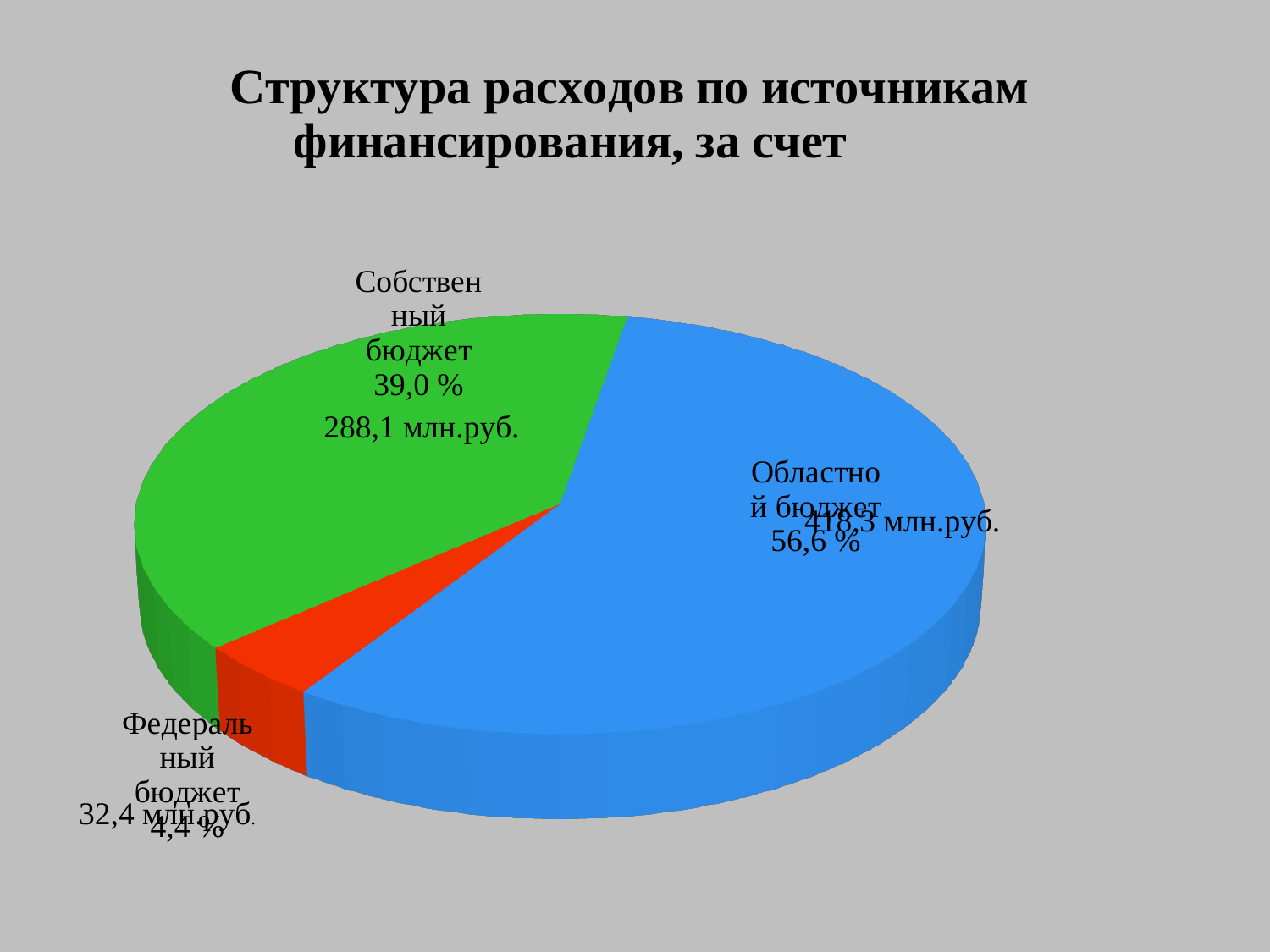
What share of the pie does Областной бюджет represent? 56,6 % What is the difference in percentage points between the shares of Областной бюджет and Собственный бюджет? 17,6 % Which source of financing has the smallest share of the pie? Федеральный бюджет What colour is the slice for Федеральный бюджет? red What share of the pie does Федеральный бюджет represent? 4,4 % What is the amount in млн.руб. for Федеральный бюджет? 32,4 млн.руб. How many slices does the pie chart have? 3 Which source of financing has the largest share of the pie? Областной бюджет What share of the pie does Собственный бюджет represent? 39,0 % What kind of chart is shown on the slide? pie chart Which is larger, the share for Собственный бюджет or the share for Федеральный бюджет? Собственный бюджет What is the amount in млн.руб. for Собственный бюджет? 288,1 млн.руб.